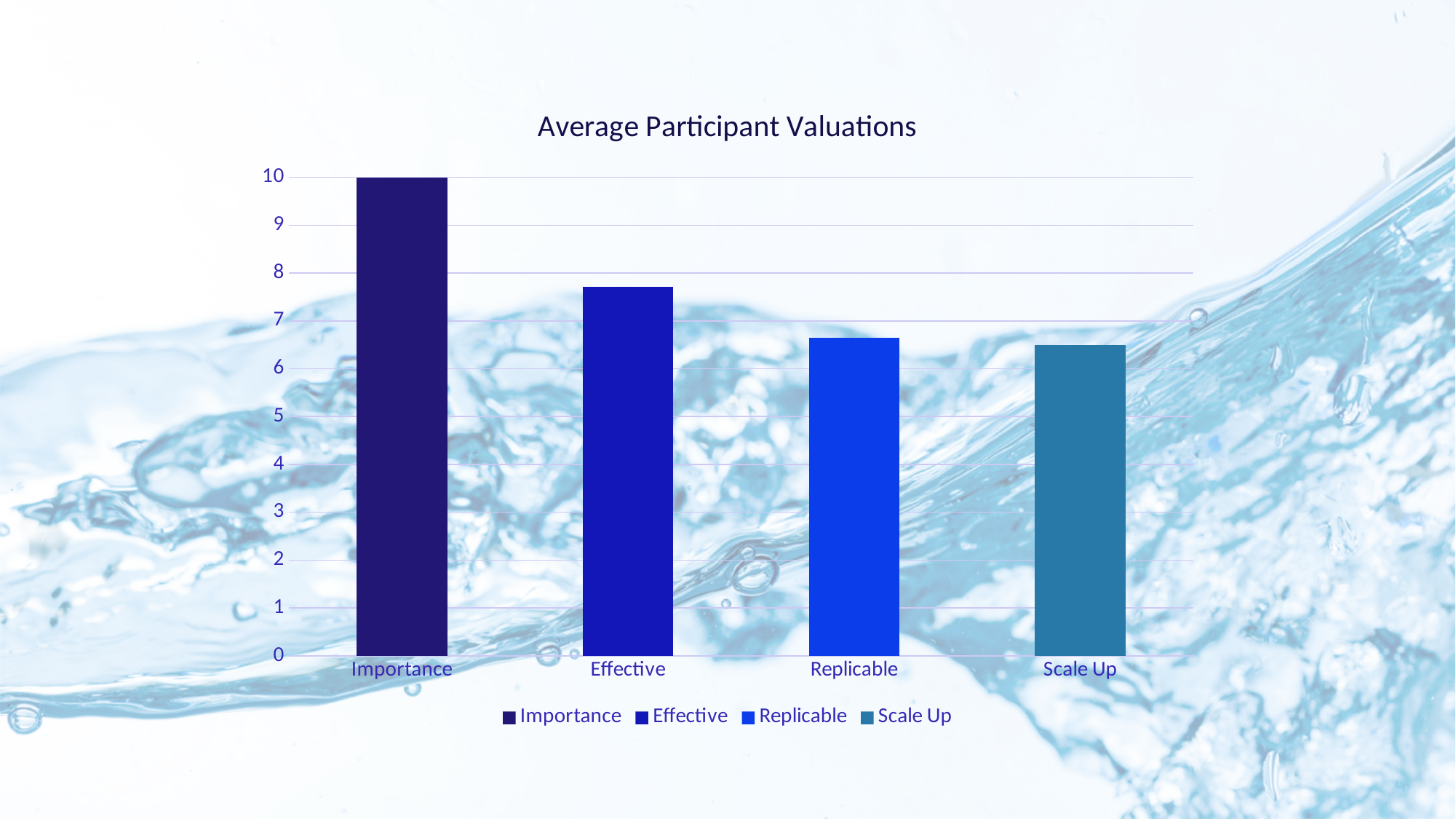
Is the value for Effective greater or less than 7? greater Which is larger, the value for Effective or the value for Replicable? Effective Is the value for Scale Up greater or less than 6? greater How many entries does the chart's legend list? 4 Which is larger, the value for Importance or the value for Effective? Importance Which category has the highest value? Importance What is the value for Importance? 10 Do the values rise or fall from left to right across the categories? fall How many categories are shown on the x axis of the chart? 4 What kind of chart is shown on the slide? bar chart Is the value for Replicable greater or less than 7? less What is the title of the chart? Average Participant Valuations